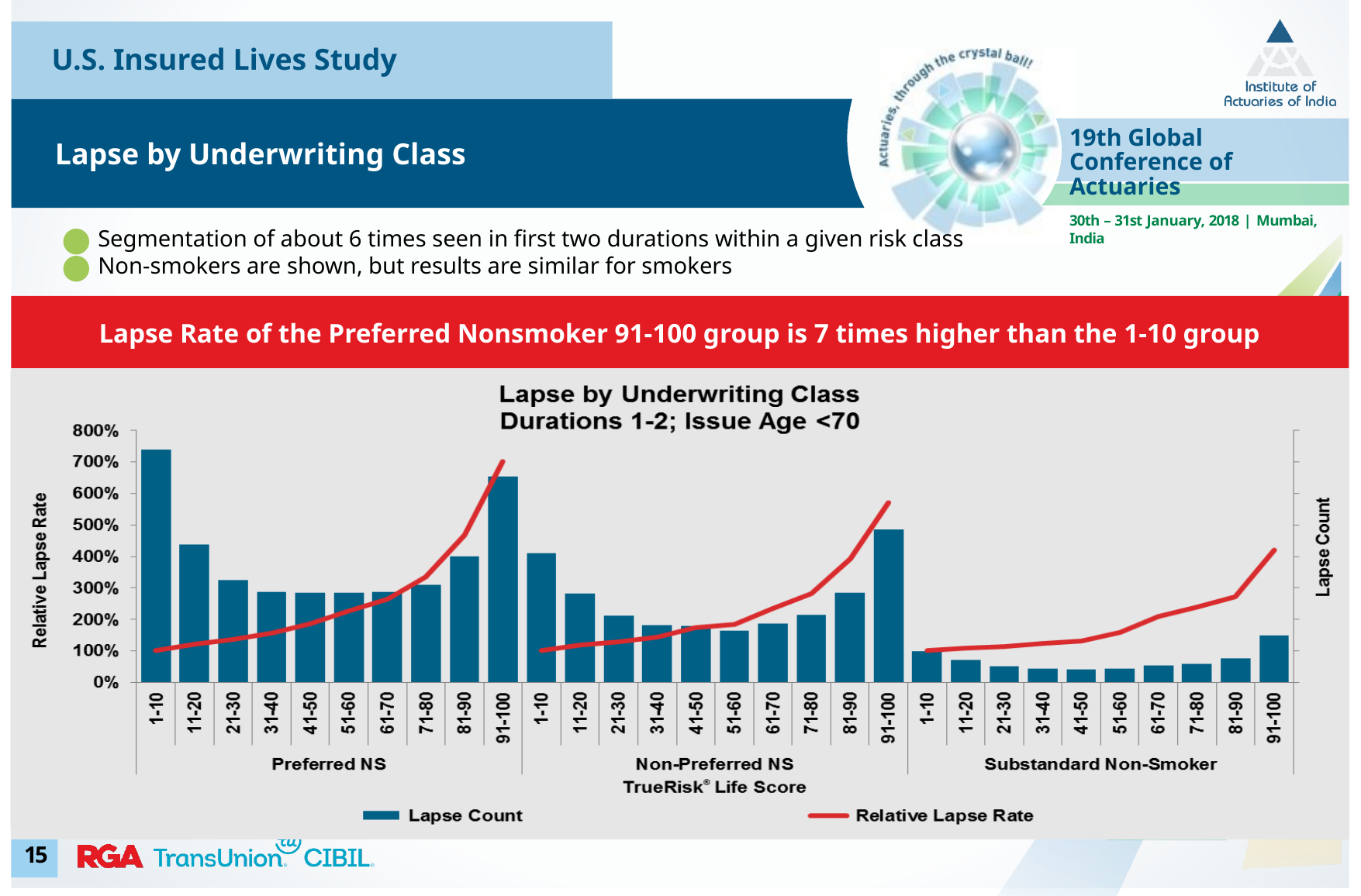
How many TrueRisk Life Score bins are shown for each underwriting class? 10 How many series does the chart legend list? 2 Is the Relative Lapse Rate for the Non-Preferred NS 91-100 group greater or less than 500%? greater What kind of chart is shown on the slide? A combination bar and line chart Which underwriting class has the highest Relative Lapse Rate at the 91-100 score bin? Preferred NS Is the Relative Lapse Rate for the Preferred NS 91-100 group greater or less than 600%? greater What is the title of the chart? Lapse by Underwriting Class Durations 1-2; Issue Age <70 Within each underwriting class, does the Relative Lapse Rate rise or fall as the TrueRisk Life Score increases from 1-10 to 91-100? rise What are the two series named in the chart legend? Lapse Count and Relative Lapse Rate How many underwriting class groups are shown along the x axis? 3 In the Preferred NS group, which has the larger Lapse Count bar, the 1-10 bin or the 91-100 bin? 1-10 Is the Relative Lapse Rate for the Substandard Non-Smoker 91-100 group greater or less than 500%? less